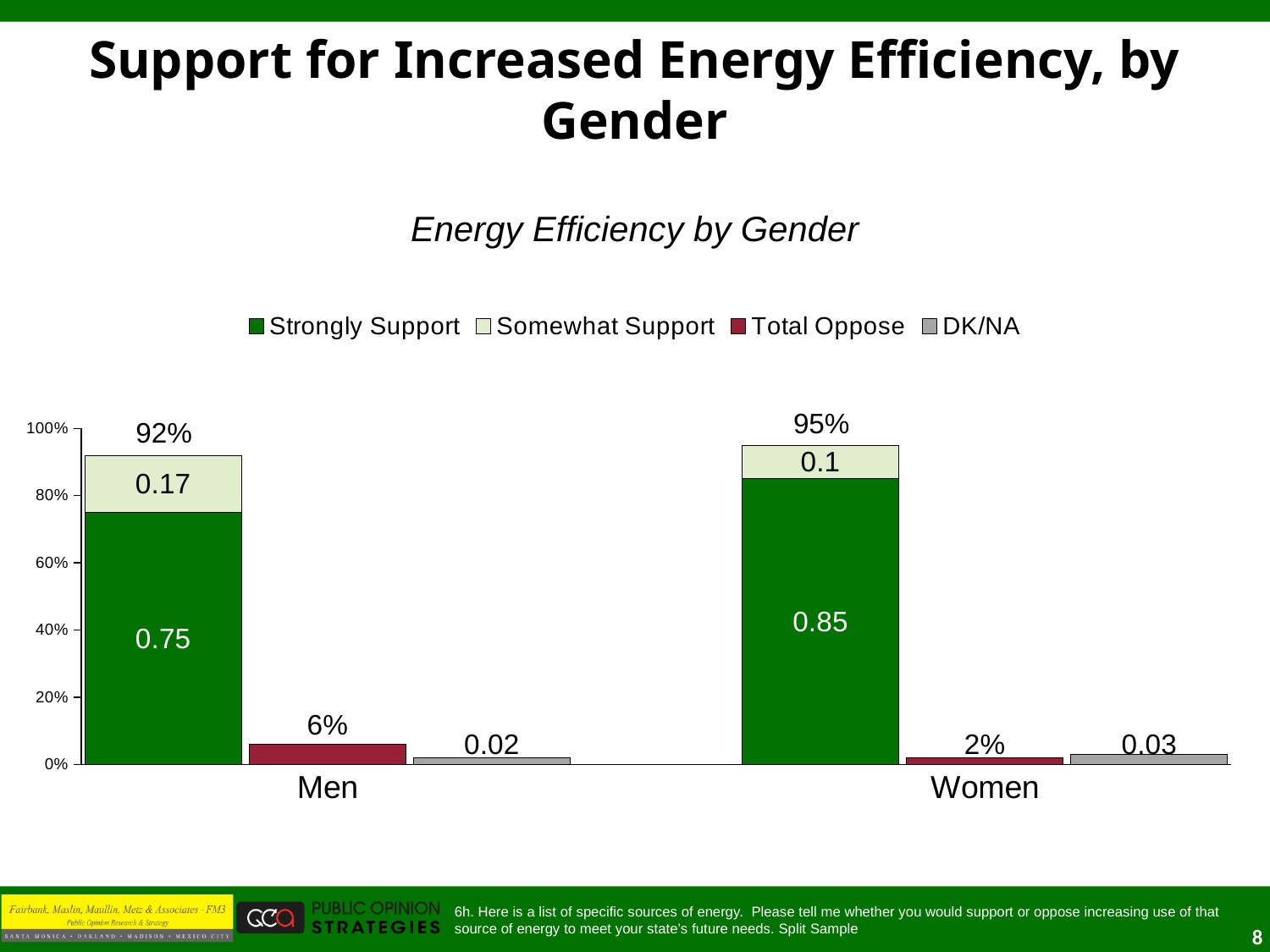
What is the Total Oppose value for Women? 2% How many gender categories are shown on the x axis? 2 What type of chart is shown on the slide? Bar chart What is the Strongly Support value for Women? 0.85 What is the Somewhat Support value for Men? 0.17 Which gender has the higher Total Oppose value? Men What is the DK/NA value for Men? 0.02 What is the Strongly Support value for Men? 0.75 What is the total support (stacked bar label) shown for Women? 95% Which gender has the higher Strongly Support value? Women How many series does the legend list? 4 What is the total support (stacked bar label) shown for Men? 92%